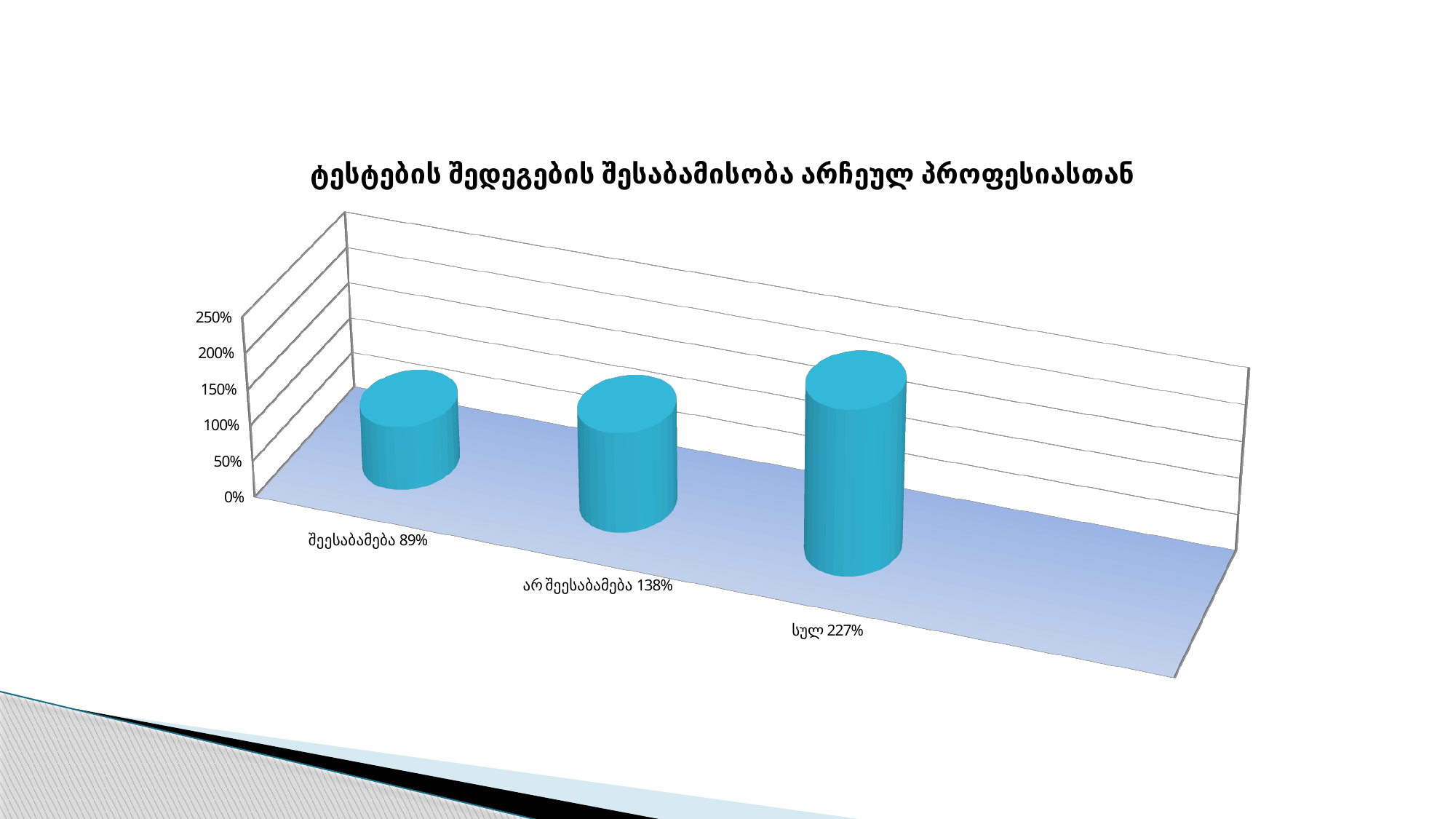
What kind of chart is shown on the slide? Bar chart What value is shown for the category სულ? 227% Which category has the lowest value? შეესაბამება Which is larger, the value for შესაბამება or the value for არ შესაბამება? არ შეესაბამება How many categories are plotted in the chart? 3 What is the difference between the values for სულ and არ შესაბამება? 89% What value is shown for the category შესაბამება? 89% What is the title of the chart? ტესტების შედეგების შესაბამისობა არჩეულ პროფესიასთან Is the value for სულ greater or less than 200%? greater Which category has the highest value? სულ What value is shown for the category არ შესაბამება? 138% What is the difference between the values for არ შესაბამება and შესაბამება? 49%